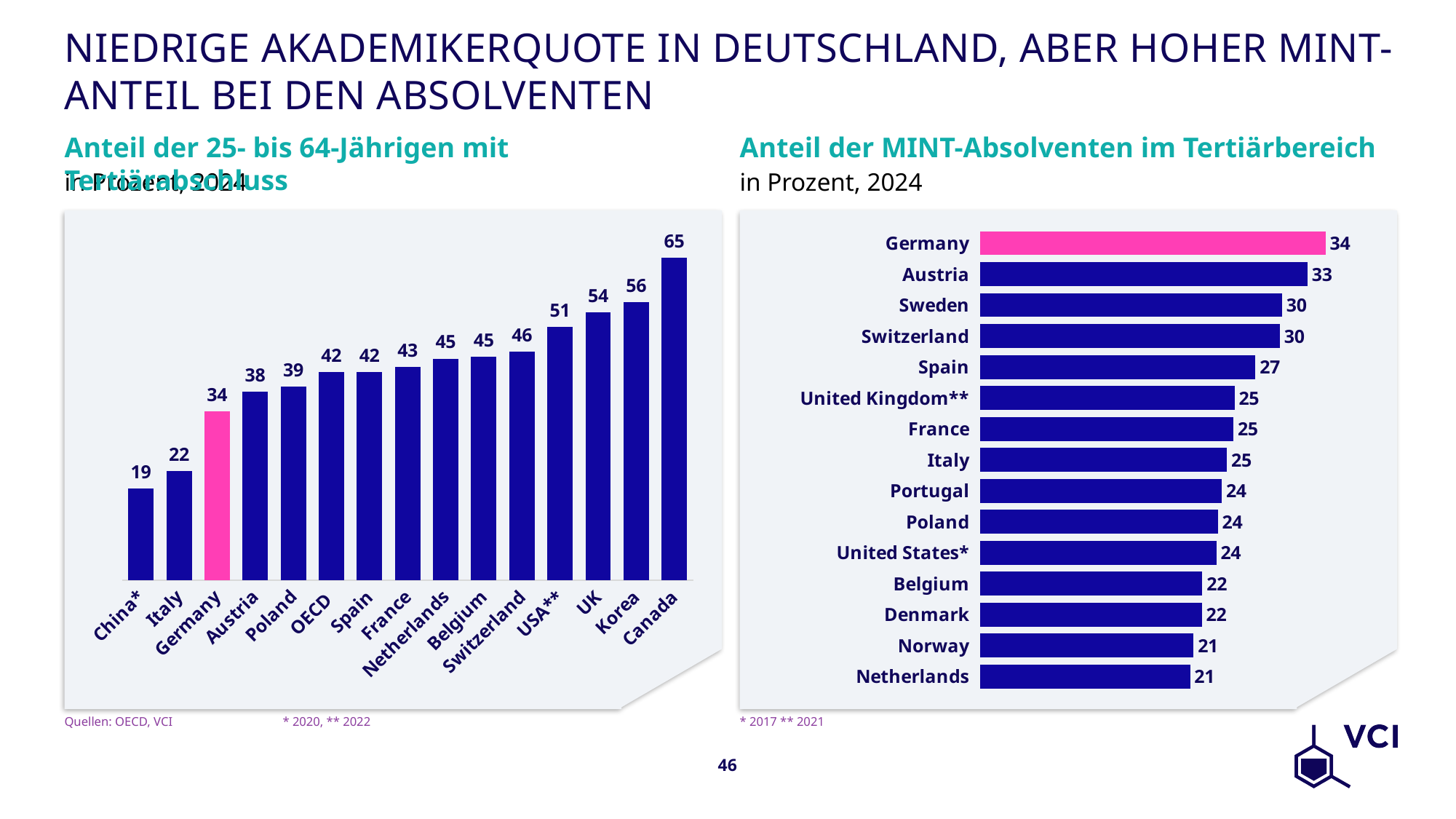
In the left chart (Anteil der 25- bis 64-Jährigen mit Tertiärabschluss), what is the difference between Canada and Germany? 31 In the left chart (Anteil der 25- bis 64-Jährigen mit Tertiärabschluss), what is the value for Germany? 34 In the left chart (Anteil der 25- bis 64-Jährigen mit Tertiärabschluss), which category has the lowest value? China* In the left chart (Anteil der 25- bis 64-Jährigen mit Tertiärabschluss), how many categories are shown? 15 In the right chart (Anteil der MINT-Absolventen im Tertiärbereich), which country's bar is highlighted in pink? Germany In the right chart (Anteil der MINT-Absolventen im Tertiärbereich), what is the difference between Germany and Netherlands? 13 In the left chart (Anteil der 25- bis 64-Jährigen mit Tertiärabschluss), do the values rise or fall from left to right? rise In the left chart (Anteil der 25- bis 64-Jährigen mit Tertiärabschluss), which country has the highest value? Canada In the right chart (Anteil der MINT-Absolventen im Tertiärbereich), what is the value for Spain? 27 In the right chart (Anteil der MINT-Absolventen im Tertiärbereich), which country has the highest value? Germany What kind of chart is the right chart (Anteil der MINT-Absolventen im Tertiärbereich)? bar chart In the right chart (Anteil der MINT-Absolventen im Tertiärbereich), which is larger, Austria or Sweden? Austria